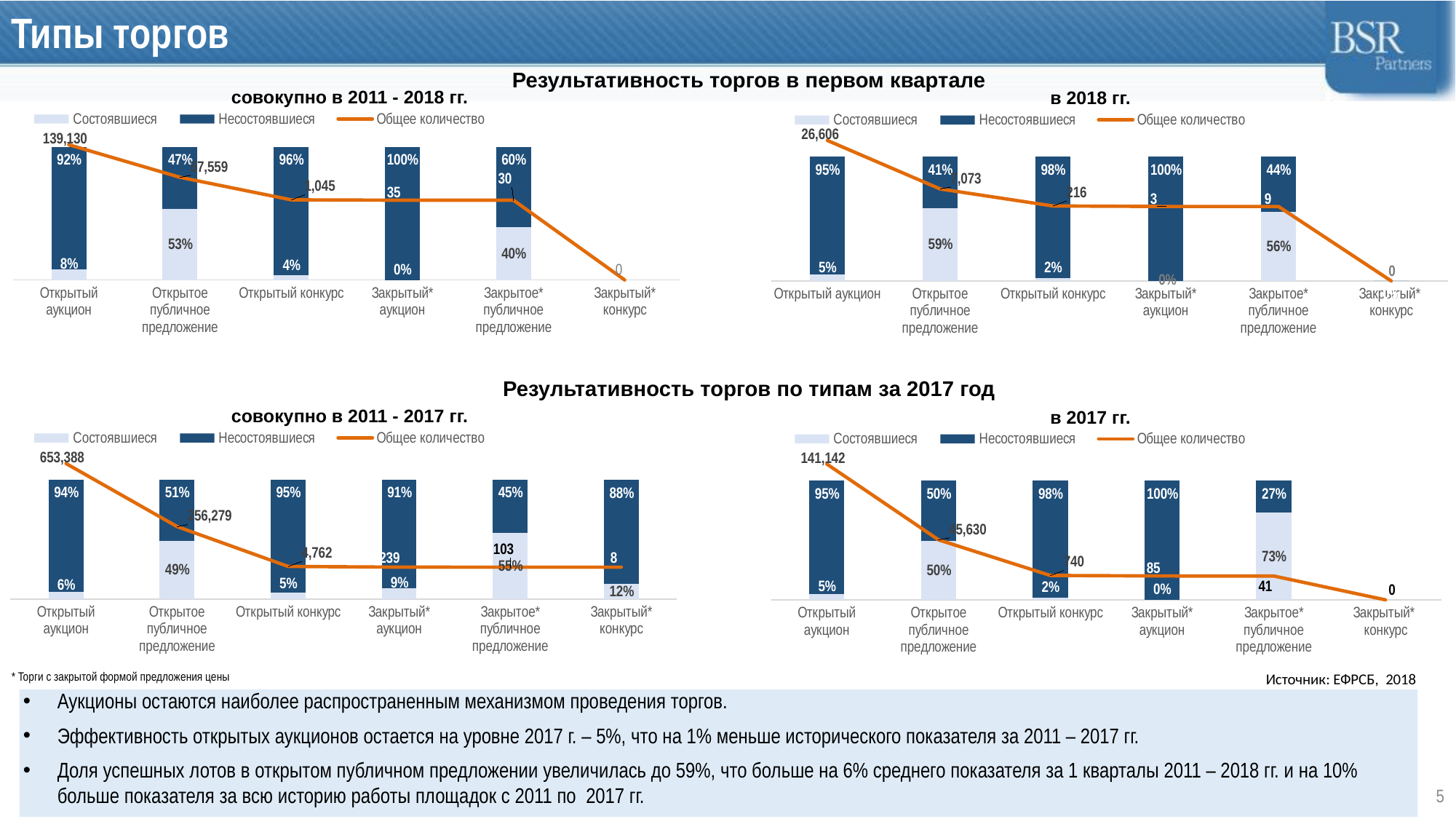
On the chart titled 'совокупно в 2011 - 2017 гг.', what is the total number (Общее количество) for Открытый аукцион? 653,388 On the chart titled 'в 2017 гг.', what share of Закрытое* публичное предложение is Состоявшиеся? 73% On the chart titled 'совокупно в 2011 - 2018 гг.', what share of Открытое публичное предложение is Несостоявшиеся? 47% On the chart titled 'совокупно в 2011 - 2017 гг.', does the total number (Общее количество) line rise or fall from Открытый аукцион to Закрытый* конкурс? Fall On the chart titled 'в 2018 гг.', which is larger: the Состоявшиеся share for Открытое публичное предложение or for Закрытое* публичное предложение? Открытое публичное предложение On the chart titled 'совокупно в 2011 - 2017 гг.', what is the difference between the total number for Закрытый* аукцион and Закрытое* публичное предложение? 136 What kind of chart is the chart titled 'в 2018 гг.'? Stacked bar chart with a line How many series does the legend of the chart titled 'совокупно в 2011 - 2018 гг.' list? 3 On the chart titled 'в 2018 гг.', what is the total number (Общее количество) for Открытый аукцион? 26,606 On the chart titled 'в 2018 гг.', which category has the highest total number (Общее количество)? Открытый аукцион How many categories are shown on the x axis of the chart titled 'в 2017 гг.'? 6 On the chart titled 'в 2017 гг.', which category has the lowest total number (Общее количество)? Закрытый* конкурс